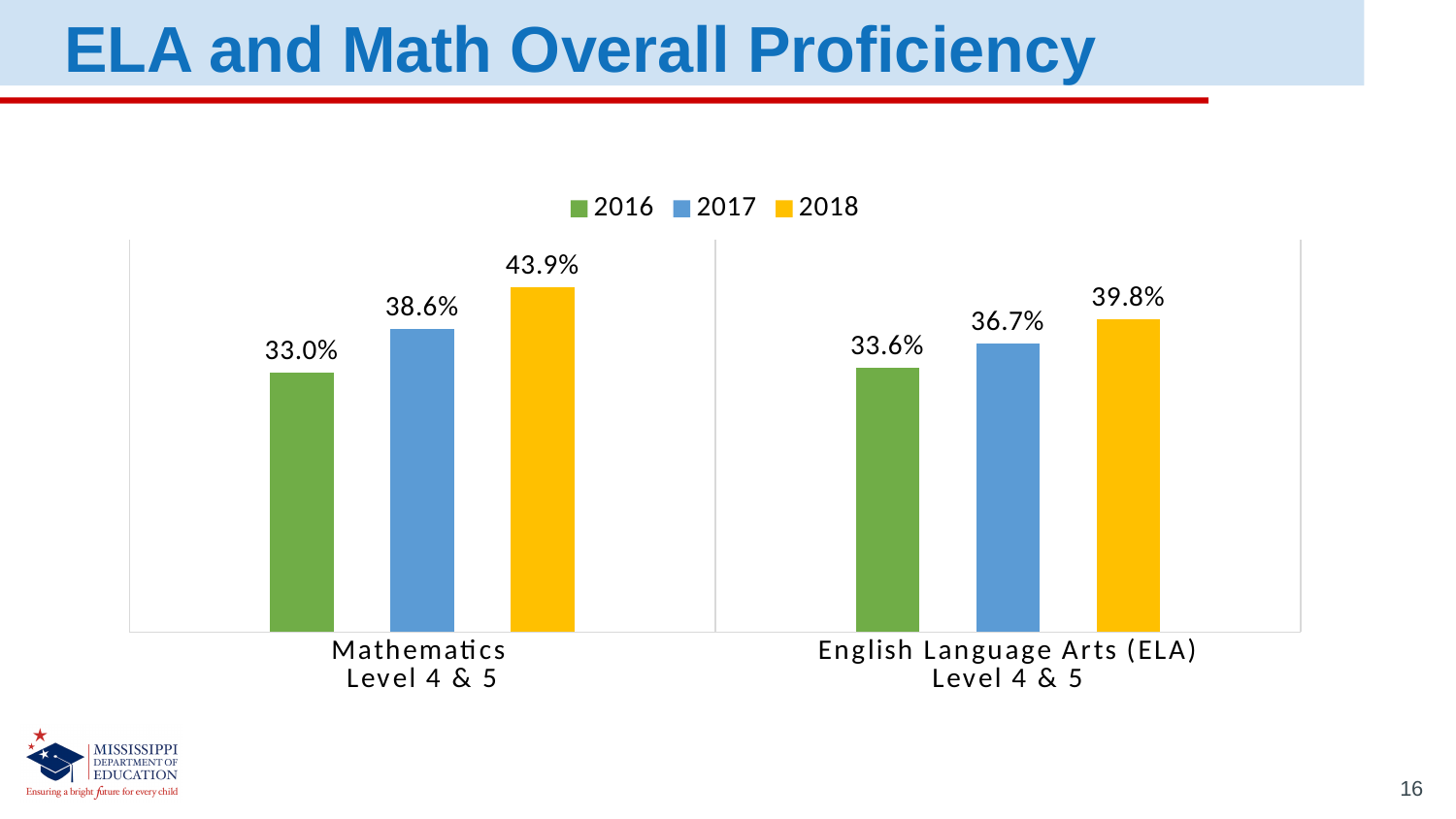
What is the 2016 value for English Language Arts (ELA) Level 4 & 5? 33.6% Which is larger, the 2017 value for Mathematics or the 2017 value for English Language Arts (ELA)? Mathematics How many categories are shown on the x axis? 2 What kind of chart is shown on the slide? Bar chart Do the values for Mathematics Level 4 & 5 rise or fall from 2016 to 2018? Rise What is the 2017 value for Mathematics Level 4 & 5? 38.6% How many series does the legend list? 3 Which year has the highest value for English Language Arts (ELA) Level 4 & 5? 2018 Which year has the lowest value for Mathematics Level 4 & 5? 2016 What is the difference between the 2018 and 2016 values for Mathematics Level 4 & 5? 10.9% What is the 2018 value for Mathematics Level 4 & 5? 43.9% What is the difference between the 2018 values for Mathematics and English Language Arts (ELA)? 4.1%